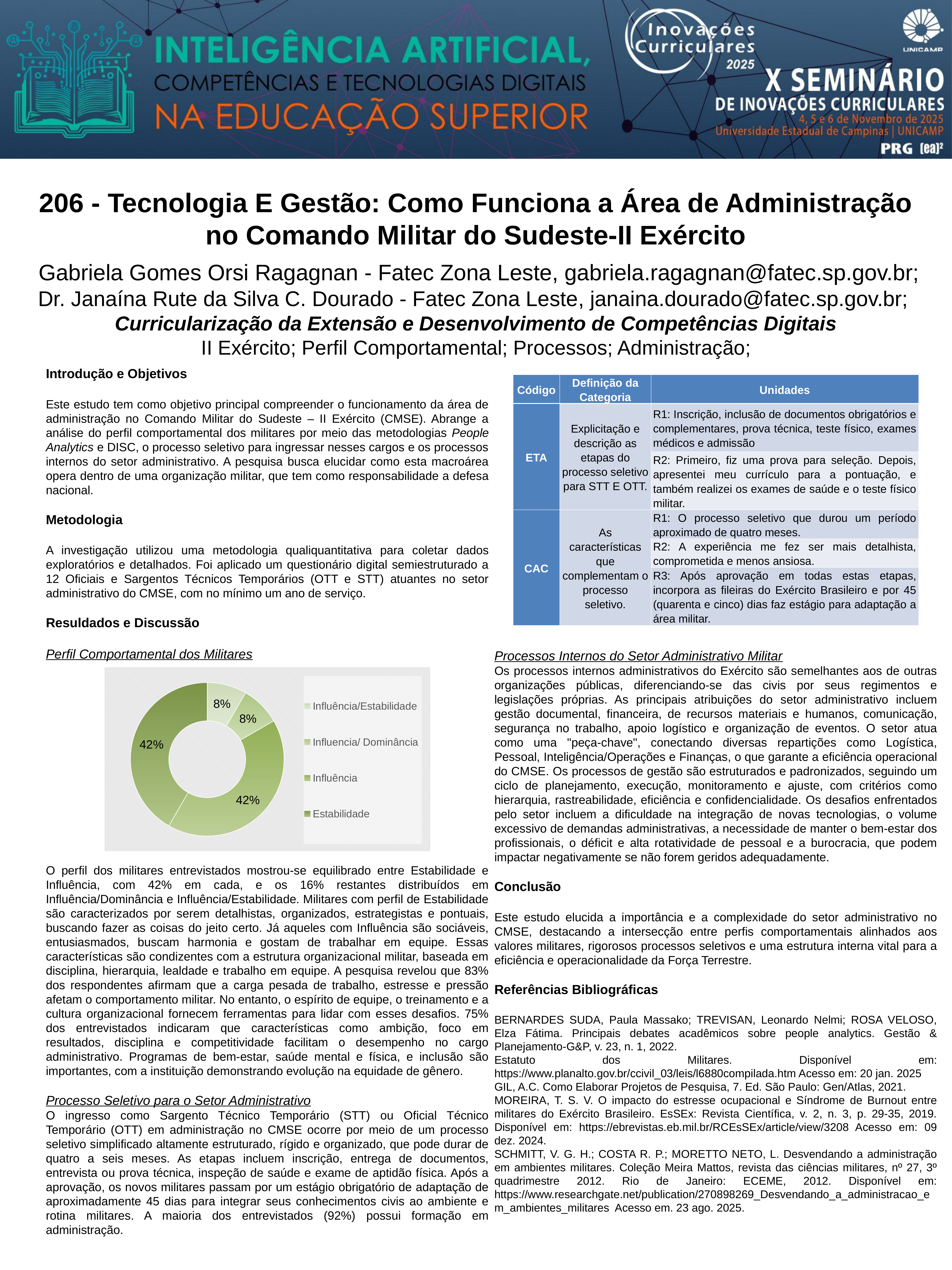
What percentage does the Influência slice show in the doughnut chart? 42% Which legend entry of the doughnut chart is shown in the darkest green? Estabilidade Which two categories share the largest value in the doughnut chart? Influência and Estabilidade How many categories does the doughnut chart show? 4 What do the two 8% slices of the doughnut chart add up to? 16% Which is larger in the doughnut chart, Estabilidade or Influencia/ Dominância? Estabilidade What kind of chart is shown under 'Perfil Comportamental dos Militares'? Doughnut (pie) chart What percentage does the Estabilidade slice show in the doughnut chart? 42% What is the difference between the Influência slice and the Influência/Estabilidade slice in the doughnut chart? 34% What percentage does the Influencia/ Dominância slice show in the doughnut chart? 8% How many entries does the legend of the doughnut chart list? 4 What percentage does the Influência/Estabilidade slice show in the doughnut chart? 8%